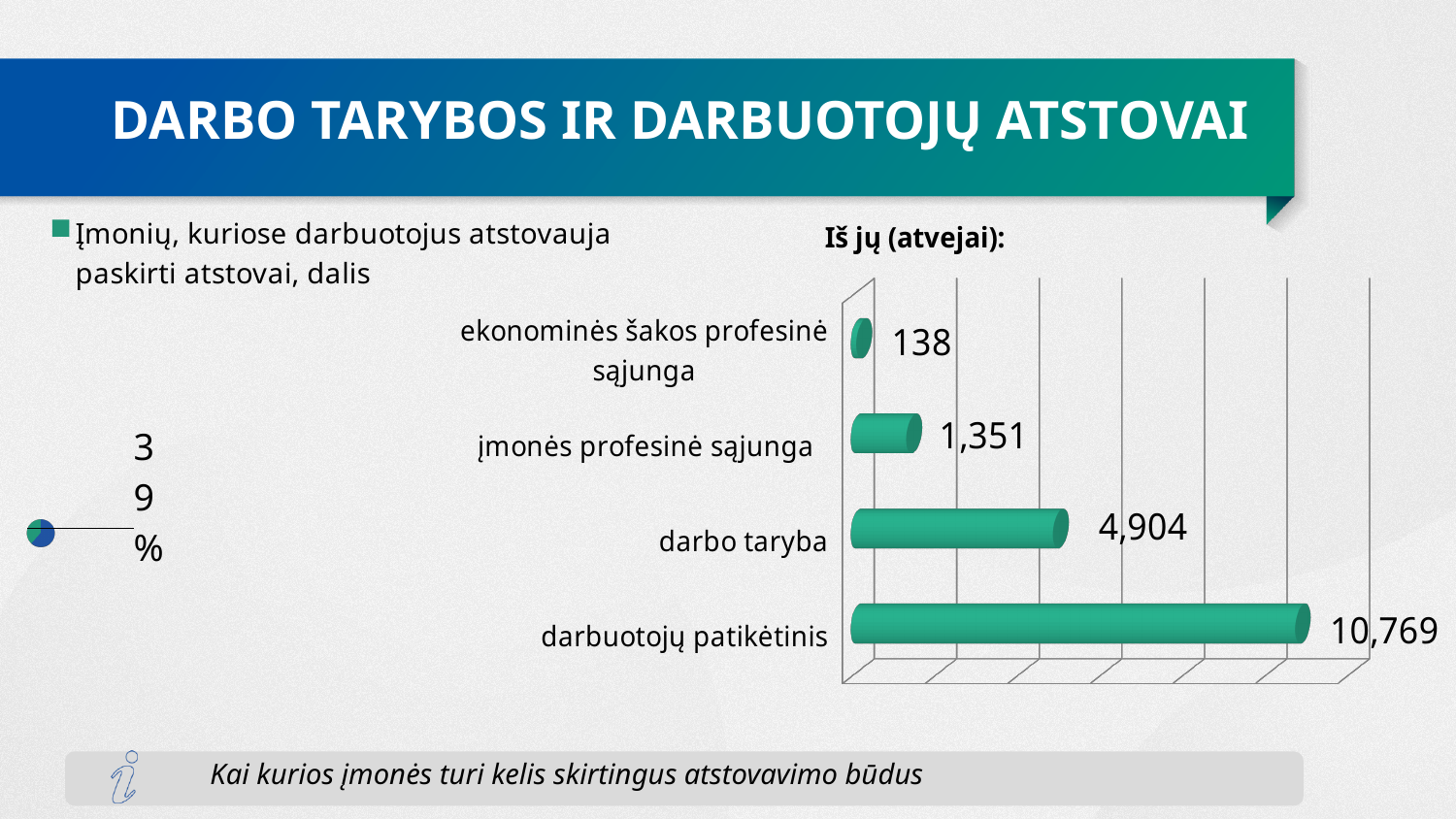
In the bar chart titled "Iš jų (atvejai):", what is the value for darbuotojų patikėtinis? 10,769 How many categories are shown in the bar chart titled "Iš jų (atvejai):"? 4 What kind of chart is the chart titled "Iš jų (atvejai):" on the right of the slide? bar chart In the pie chart on the left of the slide, what share is shown by the data label for the slice "Įmonių, kuriose darbuotojus atstovauja paskirti atstovai, dalis"? 39% In the bar chart titled "Iš jų (atvejai):", what is the difference between the values for darbuotojų patikėtinis and darbo taryba? 5,865 In the bar chart titled "Iš jų (atvejai):", which is larger: the value for darbo taryba or the value for įmonės profesinė sąjunga? darbo taryba In the bar chart titled "Iš jų (atvejai):", which category has the highest value? darbuotojų patikėtinis In the bar chart titled "Iš jų (atvejai):", what is the difference between the values for darbo taryba and įmonės profesinė sąjunga? 3,553 In the bar chart titled "Iš jų (atvejai):", which category has the lowest value? ekonominės šakos profesinė sąjunga In the bar chart titled "Iš jų (atvejai):", what is the value for ekonominės šakos profesinė sąjunga? 138 In the bar chart titled "Iš jų (atvejai):", what is the value for įmonės profesinė sąjunga? 1,351 In the bar chart titled "Iš jų (atvejai):", what is the value for darbo taryba? 4,904